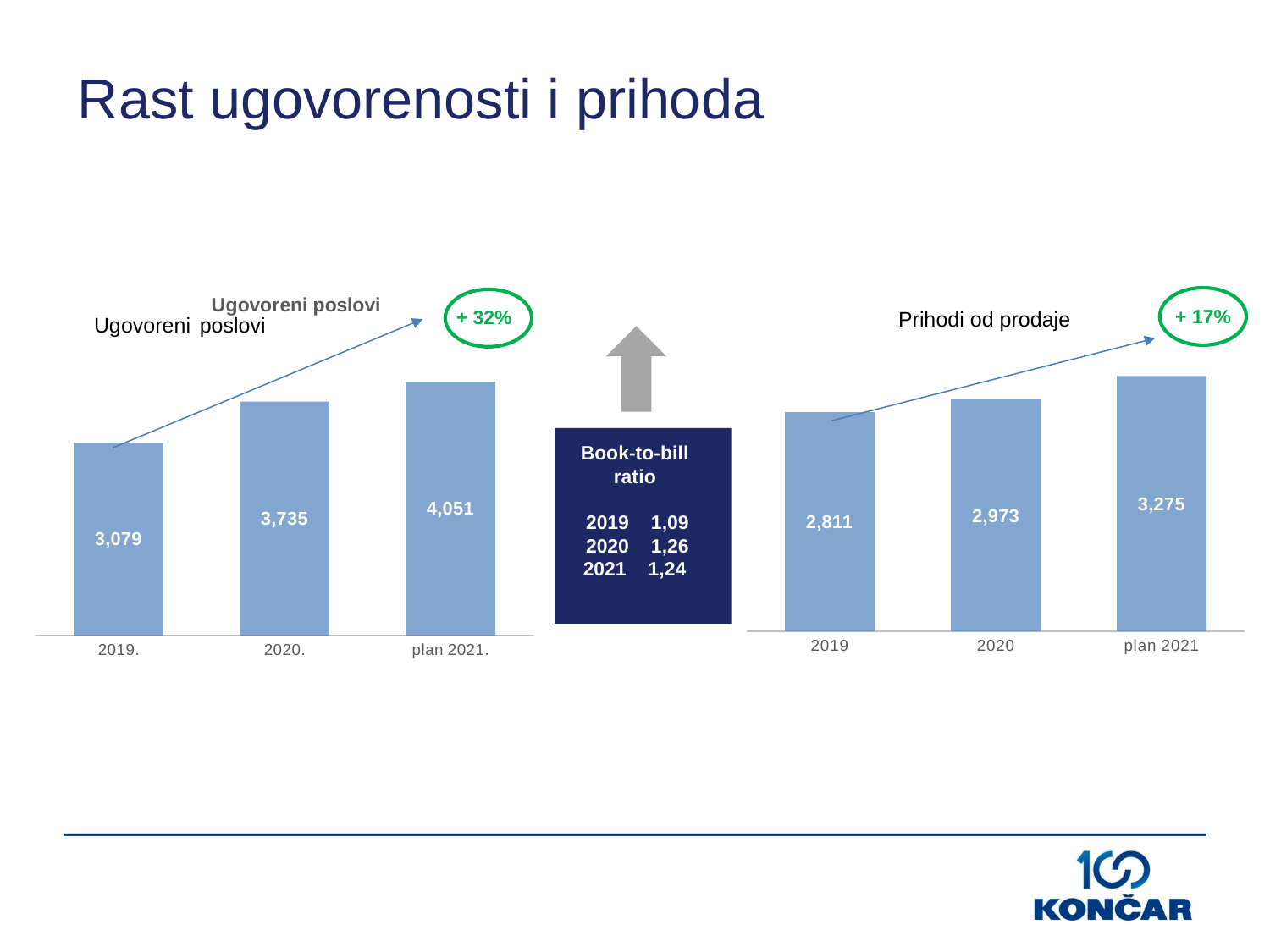
In the Ugovoreni poslovi chart, which is larger, the value for 2020. or the value for 2019.? 2020. In the Ugovoreni poslovi chart, what is the value for plan 2021.? 4,051 How many bars are in the Ugovoreni poslovi chart? 3 What percentage growth is shown in the green circle above the Ugovoreni poslovi chart? + 32% In the Prihodi od prodaje chart, do the values rise or fall from 2019 to plan 2021? rise In the Prihodi od prodaje chart, which is larger, the value for 2020 or the value for plan 2021? plan 2021 In the Prihodi od prodaje chart, what is the value for 2020? 2,973 What kind of chart is the Prihodi od prodaje chart? bar chart In the Prihodi od prodaje chart, what is the value for plan 2021? 3,275 In the Prihodi od prodaje chart, which category has the lowest value? 2019 In the Ugovoreni poslovi chart, what is the value for 2019.? 3,079 In the Ugovoreni poslovi chart, which category has the highest value? plan 2021.